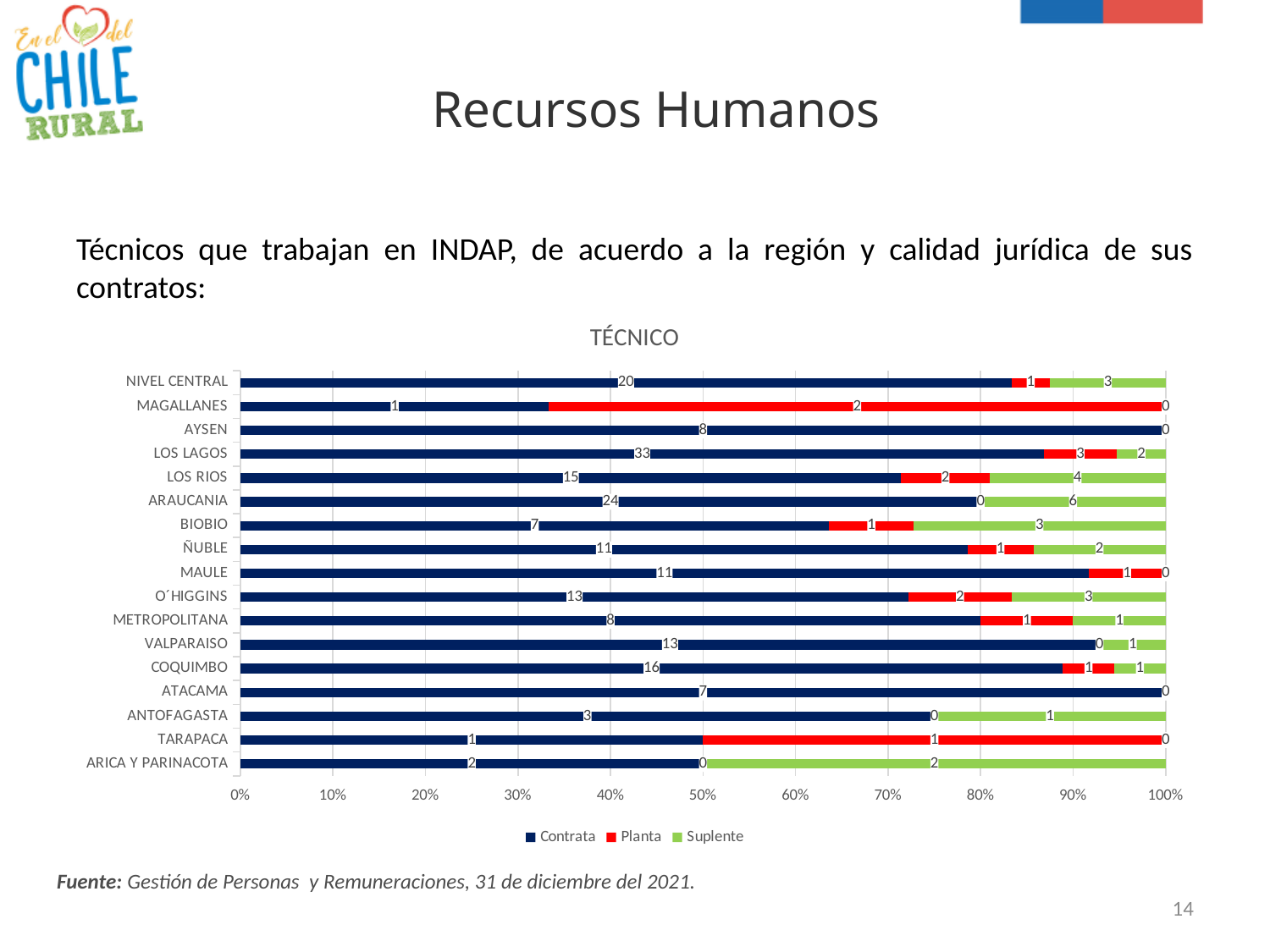
Which is larger, the Contrata value for COQUIMBO or for O´HIGGINS? COQUIMBO Is the Contrata share of the MAGALLANES bar greater or less than 40%? less What kind of chart is shown on the slide? Bar chart How many series does the legend list? 3 What is the total number of técnicos for LOS LAGOS (Contrata + Planta + Suplente)? 38 What is the difference between the Contrata values for NIVEL CENTRAL and LOS RIOS? 5 What is the Contrata value for LOS LAGOS? 33 How many regions (categories) are shown on the chart? 17 What is the title of the chart? TÉCNICO Which region has the highest Contrata value? LOS LAGOS What is the Suplente value for ARAUCANIA? 6 What is the Planta value for MAGALLANES? 2